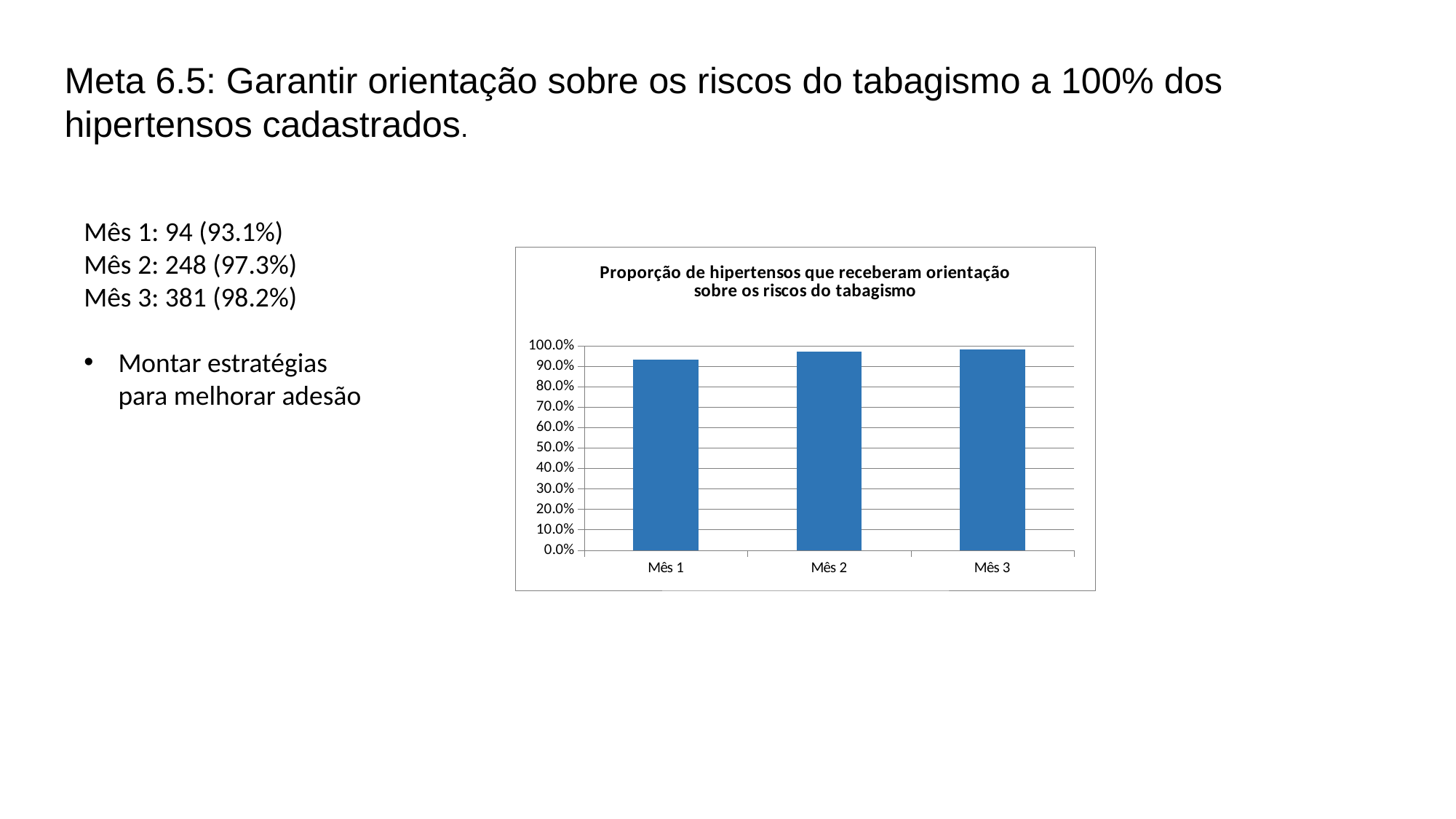
What proportion is shown for Mês 3? 98.2% Which month has the lowest proportion in the chart? Mês 1 Do the values rise or fall from Mês 1 to Mês 3? Rise What is the difference between the proportions for Mês 3 and Mês 1? 5.1% What proportion of hypertensive patients received guidance on smoking risks in Mês 1? 93.1% Is the value for Mês 1 greater or less than 90.0%? greater What proportion is shown for Mês 2? 97.3% Which month has the highest proportion in the chart? Mês 3 How many months (categories) are plotted in the chart? 3 Is the value for Mês 3 greater or less than 100.0%? less What kind of chart is shown on the slide? Bar chart What is the title of the chart? Proporção de hipertensos que receberam orientação sobre os riscos do tabagismo